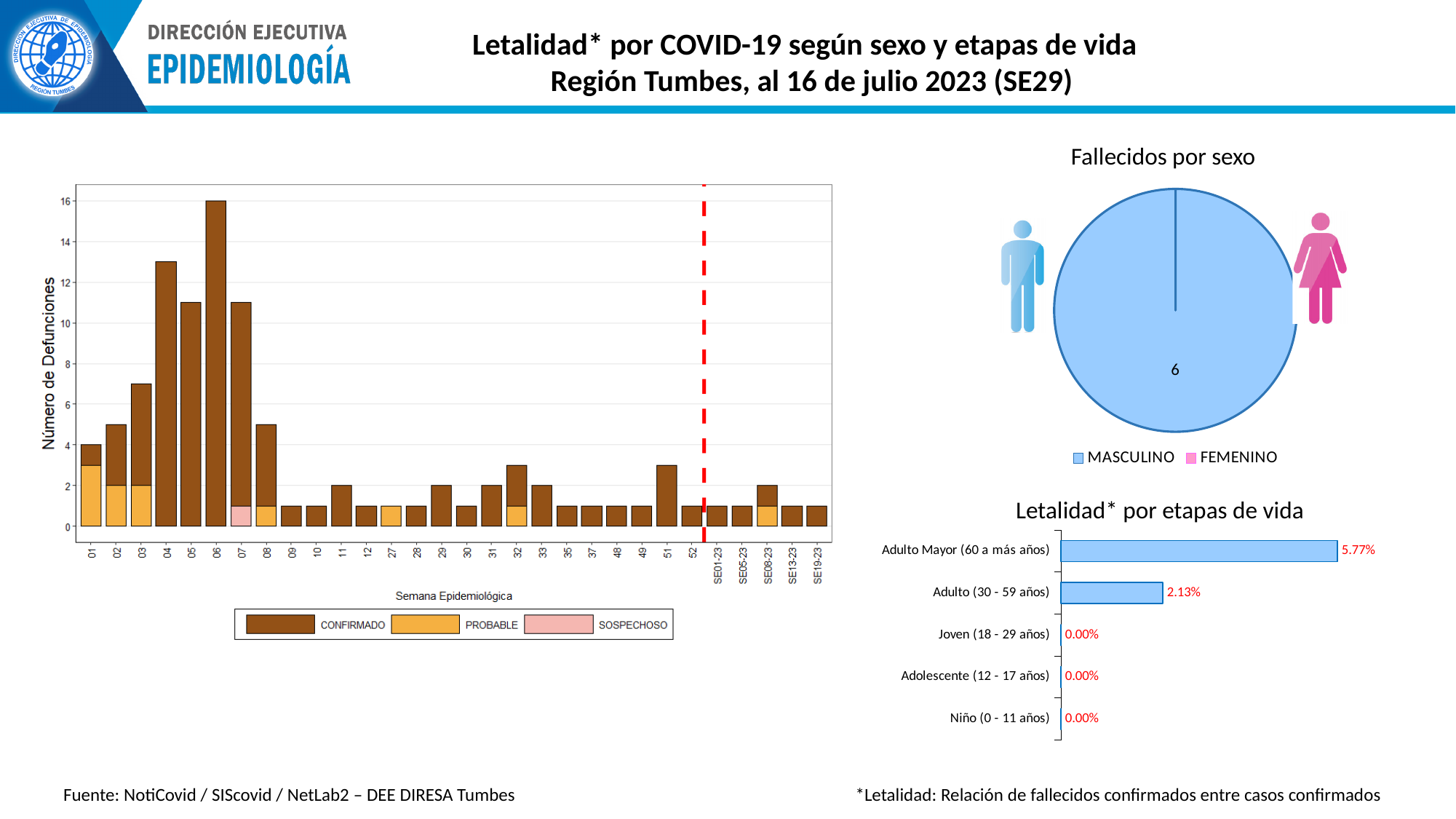
In the bar chart of deaths by epidemiological week on the left, what is the total number of deaths in week 06? 16 In the 'Letalidad* por etapas de vida' chart, which age group has the highest lethality? Adulto Mayor (60 a más años) In the 'Letalidad* por etapas de vida' chart, how many age groups are shown? 5 In the 'Letalidad* por etapas de vida' chart, what is the difference between the values for Adulto Mayor (60 a más años) and Adulto (30 - 59 años)? 3.64% How many series does the legend of the bar chart of deaths by epidemiological week list? 3 In the 'Fallecidos por sexo' pie chart, what value is shown for MASCULINO? 6 In the 'Letalidad* por etapas de vida' chart, what is the value for Adulto (30 - 59 años)? 2.13% How many series does the legend of the 'Fallecidos por sexo' pie chart list? 2 In the bar chart of deaths by epidemiological week on the left, which week has the highest number of deaths? 06 In the 'Letalidad* por etapas de vida' chart, how many age groups have a value of 0.00%? 3 In the bar chart of deaths by epidemiological week on the left, is the total for week 04 greater or less than 12? greater In the 'Letalidad* por etapas de vida' chart, what is the value for Adulto Mayor (60 a más años)? 5.77%